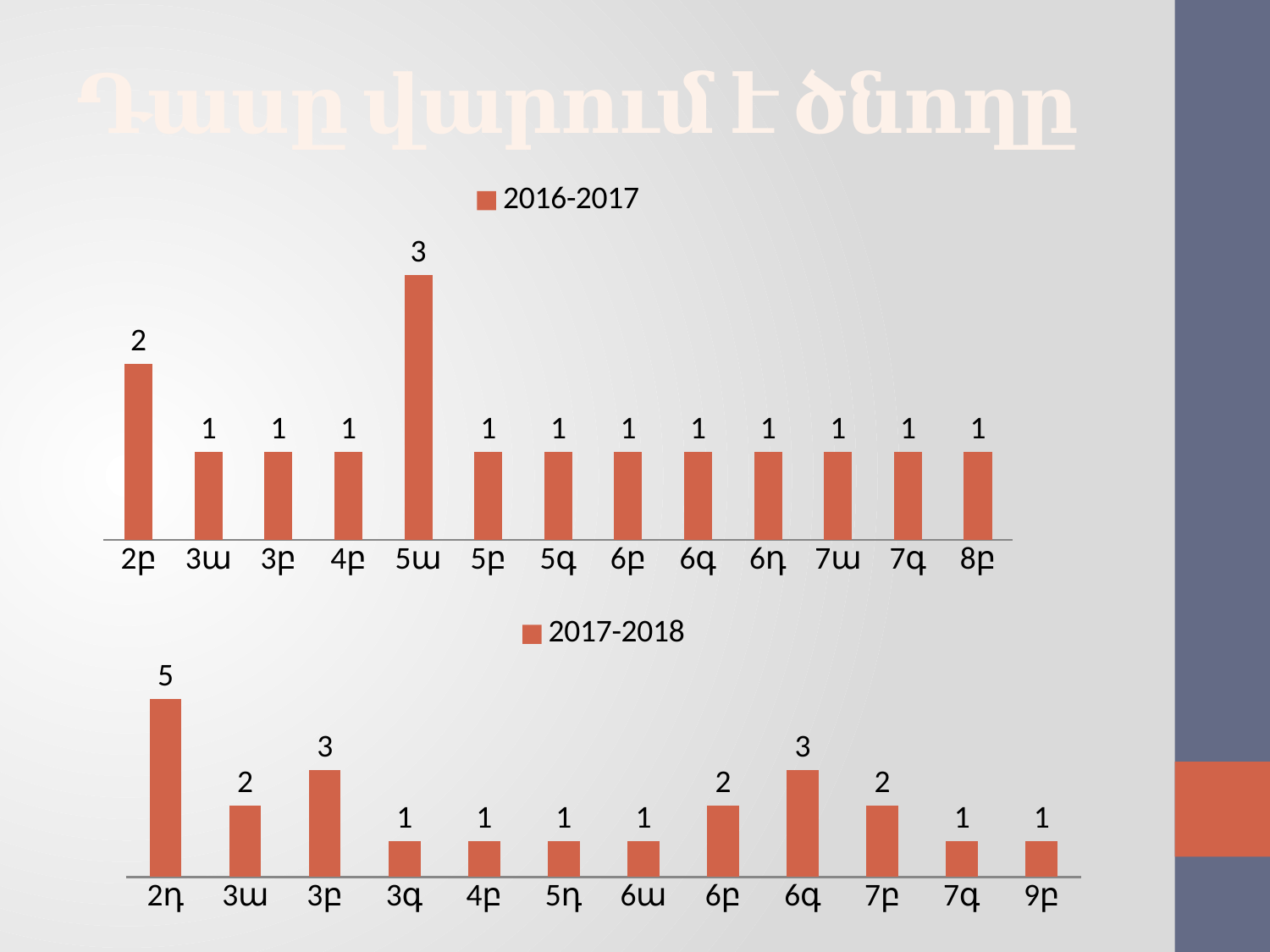
In the top chart (2016-2017), what is the difference between the values for 5ա and 2բ? 1 In the top chart (2016-2017), how many categories are shown on the x axis? 13 In the bottom chart (2017-2018), what is the value for 6գ? 3 In the bottom chart (2017-2018), which is larger, the value for 3բ or the value for 3ա? 3բ In the top chart (2016-2017), what is the value for 5ա? 3 What type of chart is the top chart (2016-2017)? Bar chart In the top chart (2016-2017), which category has the highest value? 5ա In the top chart (2016-2017), what is the value for 2բ? 2 In the bottom chart (2017-2018), how many categories are shown on the x axis? 12 In the bottom chart (2017-2018), what is the value for 2դ? 5 In the bottom chart (2017-2018), what is the difference between the values for 2դ and 7բ? 3 In the bottom chart (2017-2018), which category has the highest value? 2դ